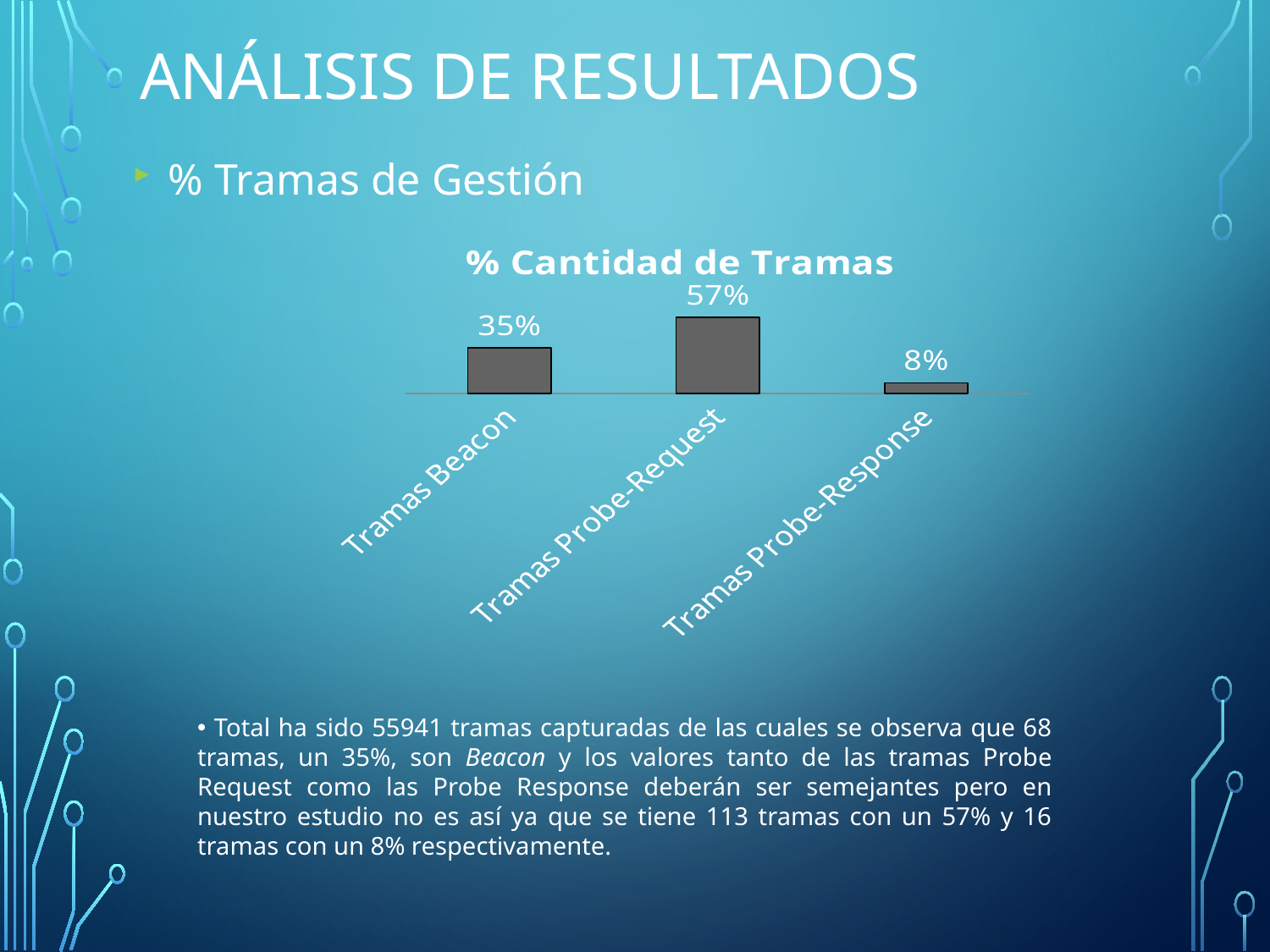
What is the difference between the values for Tramas Probe-Request and Tramas Beacon? 22% Which category has the highest value? Tramas Probe-Request What is the title of the chart? % Cantidad de Tramas Which category has the lowest value? Tramas Probe-Response What is the difference between the values for Tramas Beacon and Tramas Probe-Response? 27% What kind of chart is shown on the slide? Bar chart How many categories are shown in the chart? 3 What is the value for Tramas Probe-Request? 57% Which is larger, the value for Tramas Beacon or the value for Tramas Probe-Response? Tramas Beacon What is the total of the three values shown in the chart? 100% What is the value for Tramas Beacon? 35% What is the value for Tramas Probe-Response? 8%